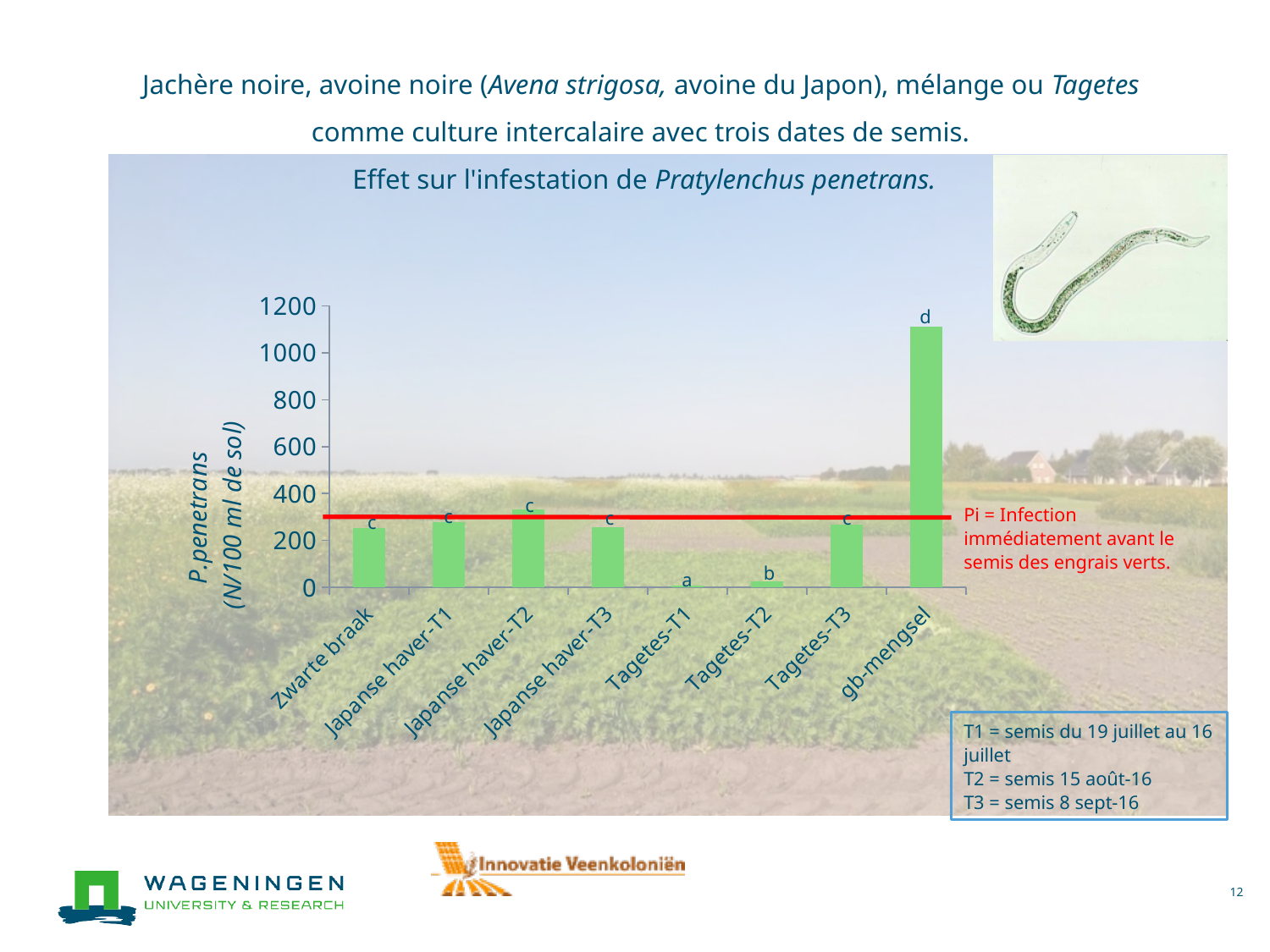
Is the value for Japanse haver-T2 greater or less than 600? less What is the highest tick value shown on the y axis of the chart? 1200 Which is larger, the value for Japanse haver-T2 or the value for Tagetes-T2? Japanse haver-T2 How many categories are shown on the x axis of the chart? 8 Is the value for Tagetes-T2 greater or less than 200? less Is the value for Tagetes-T1 greater or less than 200? less What kind of chart is shown on the slide? bar chart Which category has the highest value in the chart? gb-mengsel Which is larger, the value for gb-mengsel or the value for Zwarte braak? gb-mengsel Which letter is printed above the gb-mengsel bar? d